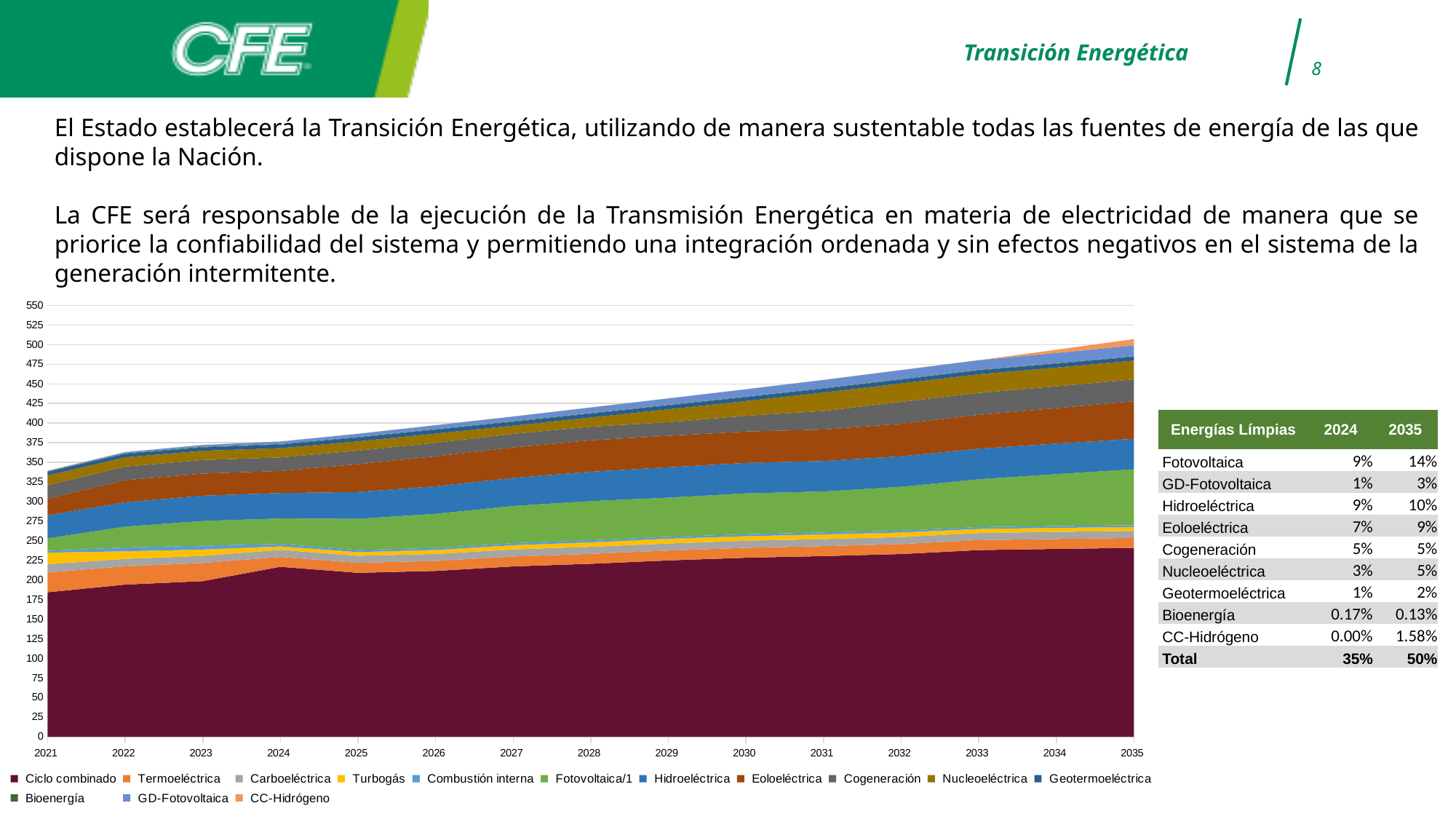
Is the total stacked value in 2021 greater or less than 400? less What is the highest value shown on the y axis of the chart? 550 Is the total stacked value in 2035 greater or less than 450? greater Which series occupies the bottom (largest) band of the stacked area chart? Ciclo combinado Does the total stacked value rise or fall from 2021 to 2035? Rises How many years are plotted along the x axis of the chart? 15 Is the value for Ciclo combinado in 2021 greater or less than 200? less How many series does the chart legend list? 14 In 2035, which is larger: the Ciclo combinado area or the Fotovoltaica/1 area? Ciclo combinado What is the first year shown on the x axis of the chart? 2021 What kind of chart is shown on the slide? Stacked area chart